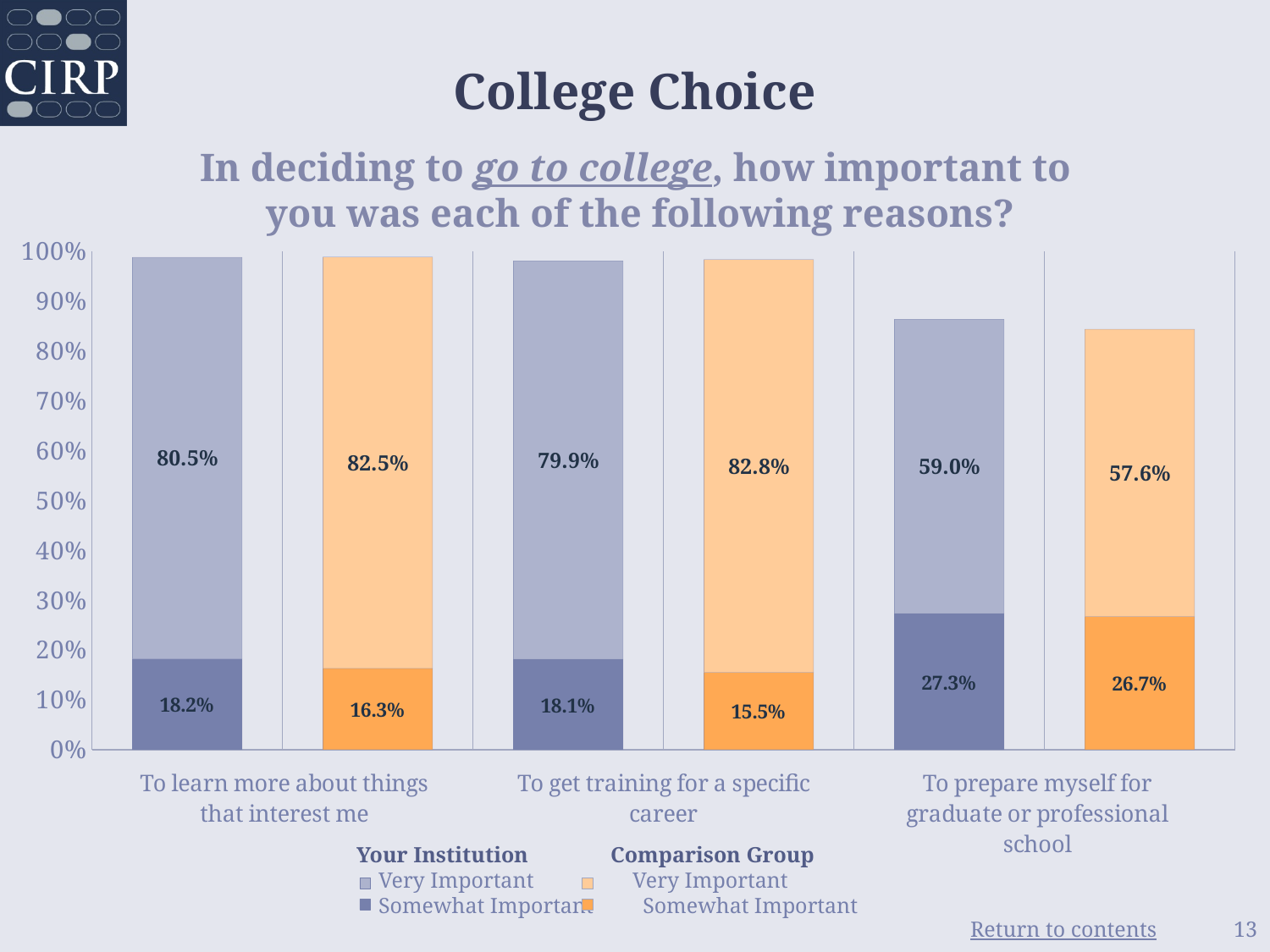
How many reasons (categories) are shown on the x axis of the chart? 3 What type of chart is shown on the slide? Stacked bar chart What is the combined Very Important and Somewhat Important total for Your Institution on "To prepare myself for graduate or professional school"? 86.3% How many series does the legend list? 4 For "To prepare myself for graduate or professional school", which is larger: the Very Important percentage for Your Institution or for the Comparison Group? Your Institution What is the difference between the Comparison Group and Your Institution Very Important percentages for "To get training for a specific career"? 2.9% What is the combined Very Important and Somewhat Important total for the Comparison Group on "To learn more about things that interest me"? 98.8% Which reason has the highest Very Important percentage for Your Institution? To learn more about things that interest me Which reason has the lowest Very Important percentage for the Comparison Group? To prepare myself for graduate or professional school What percentage of the Comparison Group rated "To get training for a specific career" as Somewhat Important? 15.5% What percentage of Your Institution students rated "To learn more about things that interest me" as Very Important? 80.5% What percentage of Your Institution students rated "To prepare myself for graduate or professional school" as Somewhat Important? 27.3%